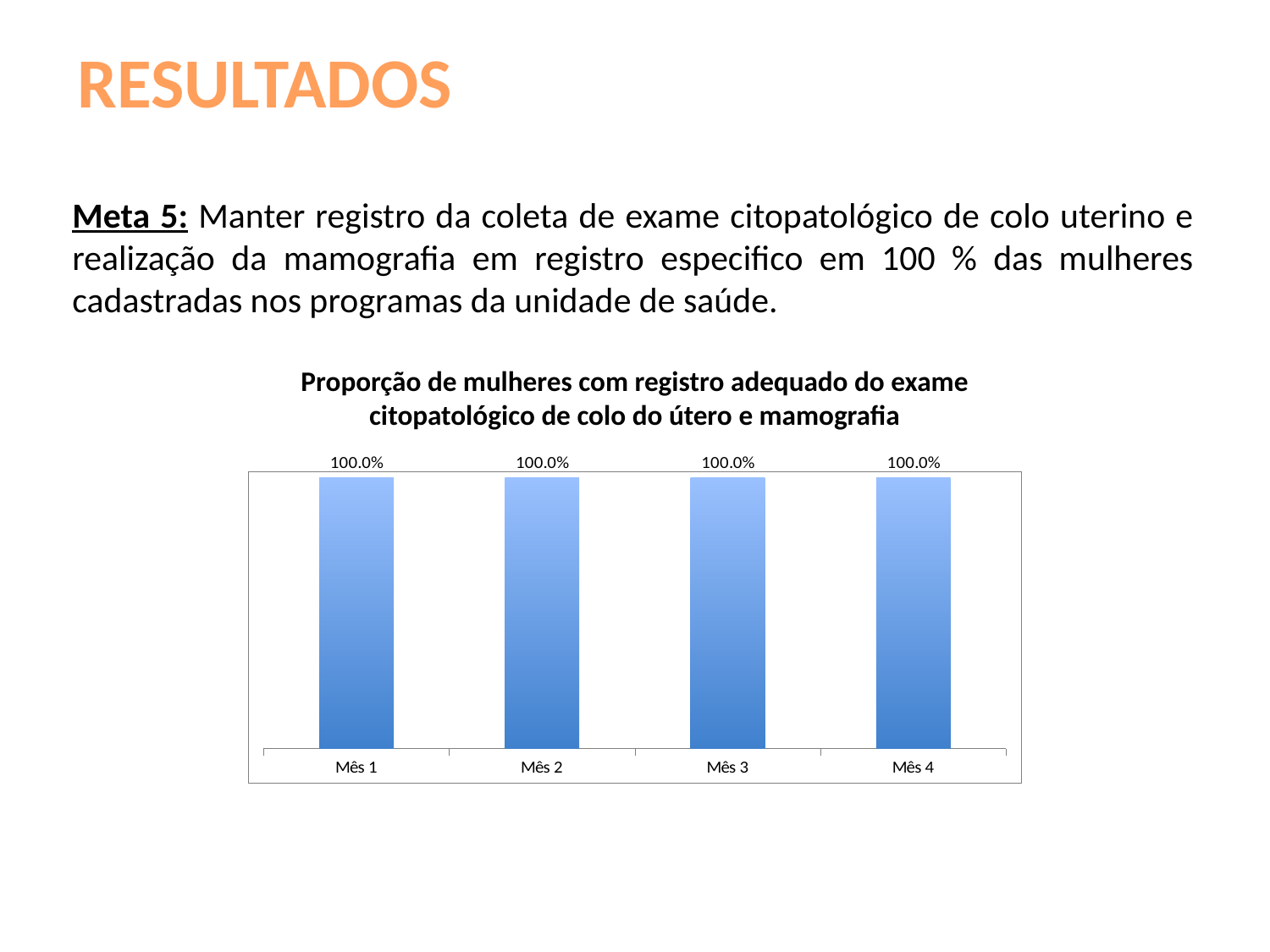
What is the value for Mês 1? 100.0% What is the difference between the values for Mês 2 and Mês 3? 0.0% What is the difference between the values for Mês 1 and Mês 4? 0.0% What is the value for Mês 2? 100.0% What is the value for Mês 3? 100.0% Do the values rise, fall or stay the same from Mês 1 to Mês 4? Stay the same What kind of chart is shown on the slide? Bar chart What colour are the bars in the chart? Blue What is the title of the chart? Proporção de mulheres com registro adequado do exame citopatológico de colo do útero e mamografia How many categories are shown on the x axis of the chart? 4 What is the value for Mês 4? 100.0%